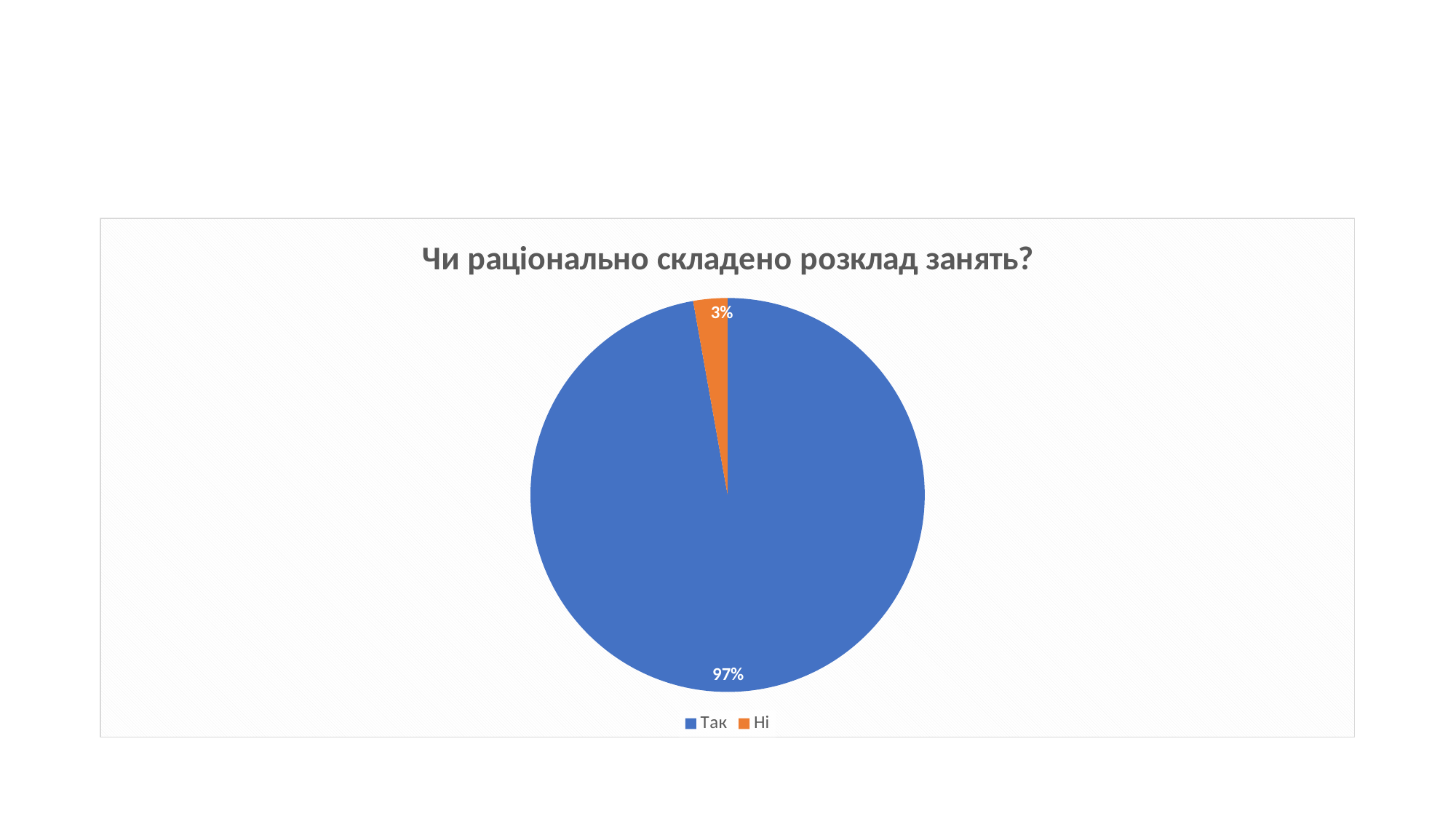
What is the title of the chart? Чи раціонально складено розклад занять? What share of the pie does "Так" take? 97% What is the difference in percentage points between "Так" and "Ні"? 94 Which is larger, the share for "Так" or the share for "Ні"? Так What share of the pie does "Ні" take? 3% What kind of chart is shown on the slide? pie chart Which category has the largest slice of the pie? Так What colour is the slice for "Ні"? orange Which category has the smallest slice of the pie? Ні How many entries does the legend list? 2 How many categories does the pie chart show? 2